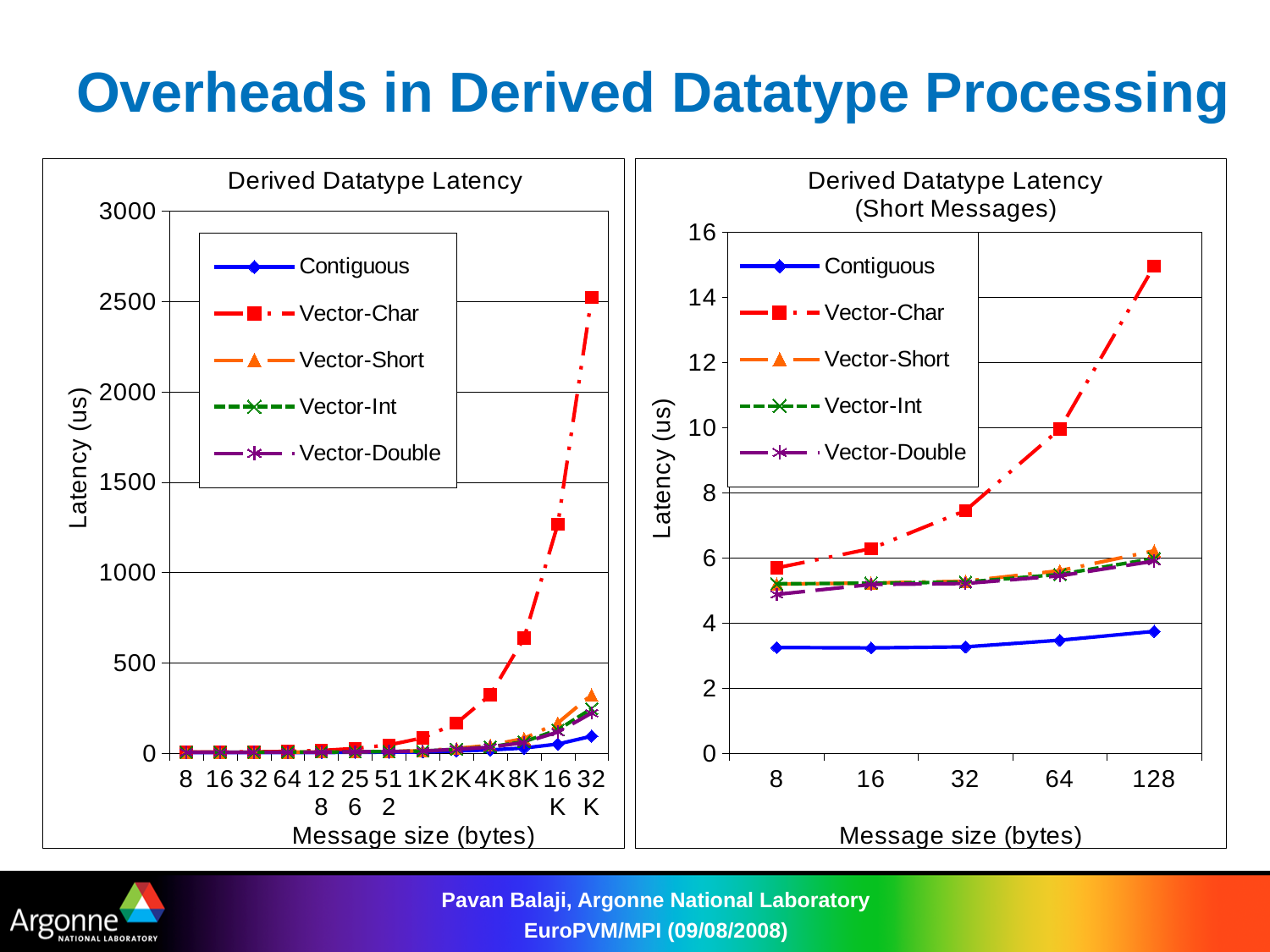
What is the y-axis label of the right chart "Derived Datatype Latency (Short Messages)"? Latency (us) In the left chart "Derived Datatype Latency", which is larger at 32K bytes: the Vector-Char latency or the Contiguous latency? Vector-Char In the right chart "Derived Datatype Latency (Short Messages)", which series has the lowest latency at 128 bytes? Contiguous How many series does the legend of the right chart "Derived Datatype Latency (Short Messages)" list? 5 In the right chart "Derived Datatype Latency (Short Messages)", does the Vector-Char latency rise or fall as message size increases? rise In the right chart "Derived Datatype Latency (Short Messages)", is the Contiguous latency at 8 bytes greater or less than 4? less How many message sizes are shown on the x axis of the right chart "Derived Datatype Latency (Short Messages)"? 5 How many message sizes are shown on the x axis of the left chart "Derived Datatype Latency"? 13 What kind of chart is the left chart titled "Derived Datatype Latency"? line chart In the right chart "Derived Datatype Latency (Short Messages)", is the Vector-Char latency at 128 bytes greater or less than 14? greater In the left chart "Derived Datatype Latency", is the Vector-Char latency at 32K bytes greater or less than 2000? greater In the left chart "Derived Datatype Latency", which series has the highest latency at 32K bytes? Vector-Char